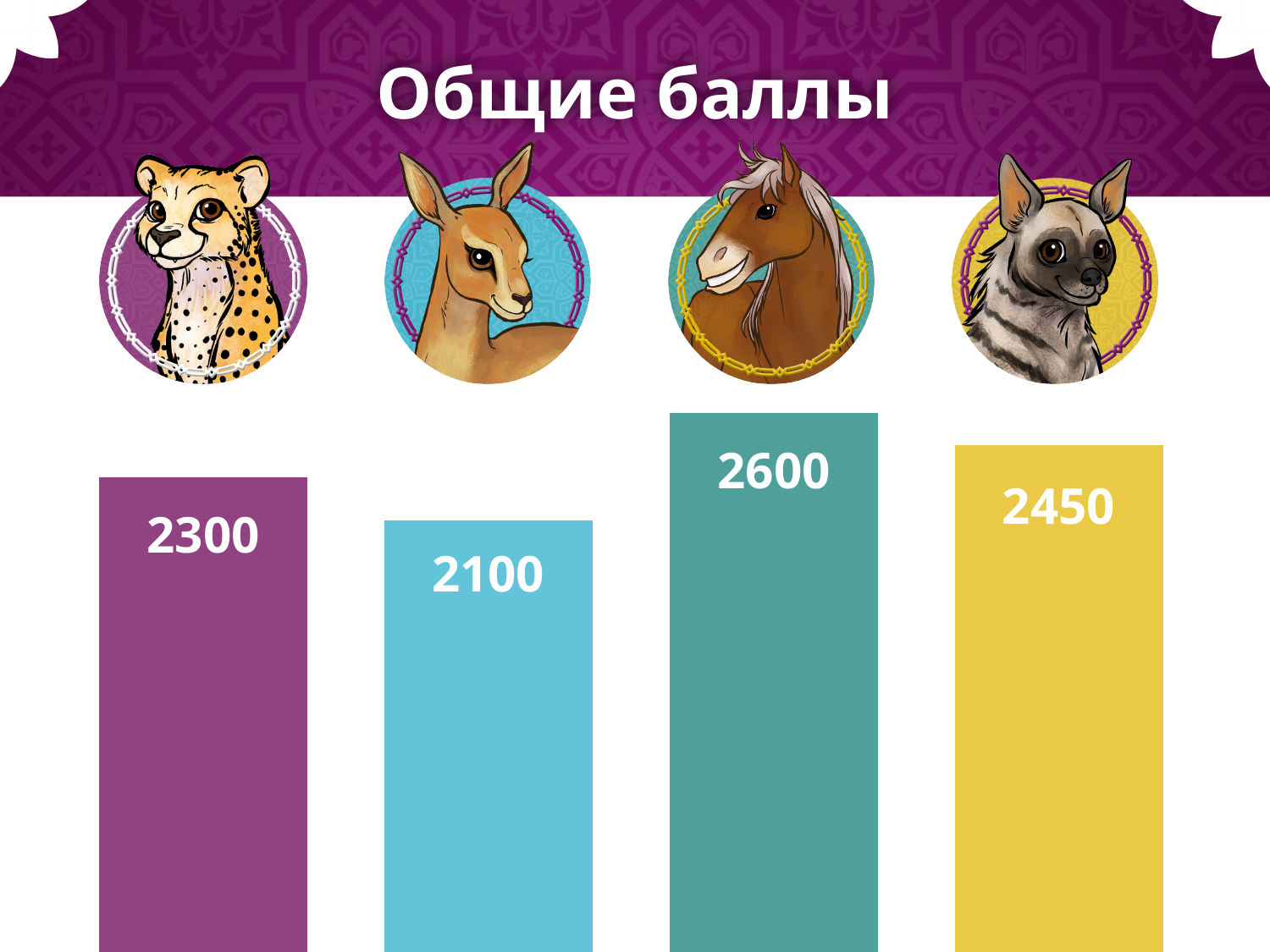
What is the title of the chart? Общие баллы What is the value of the second bar from the left (the gazelle)? 2100 How many bars are shown in the chart? 4 What kind of chart is shown on the slide? Bar chart What is the difference between the horse's bar and the gazelle's bar? 500 Which is larger, the cheetah's value or the hyena's value? The hyena's value (2450) What is the value of the fourth bar from the left (the hyena)? 2450 What is the difference between the hyena's bar and the cheetah's bar? 150 Which animal has the highest bar? The horse (third bar), 2600 What is the value of the third bar from the left (the horse)? 2600 Which animal has the lowest bar? The gazelle (second bar), 2100 What is the value of the first bar from the left (the cheetah)? 2300